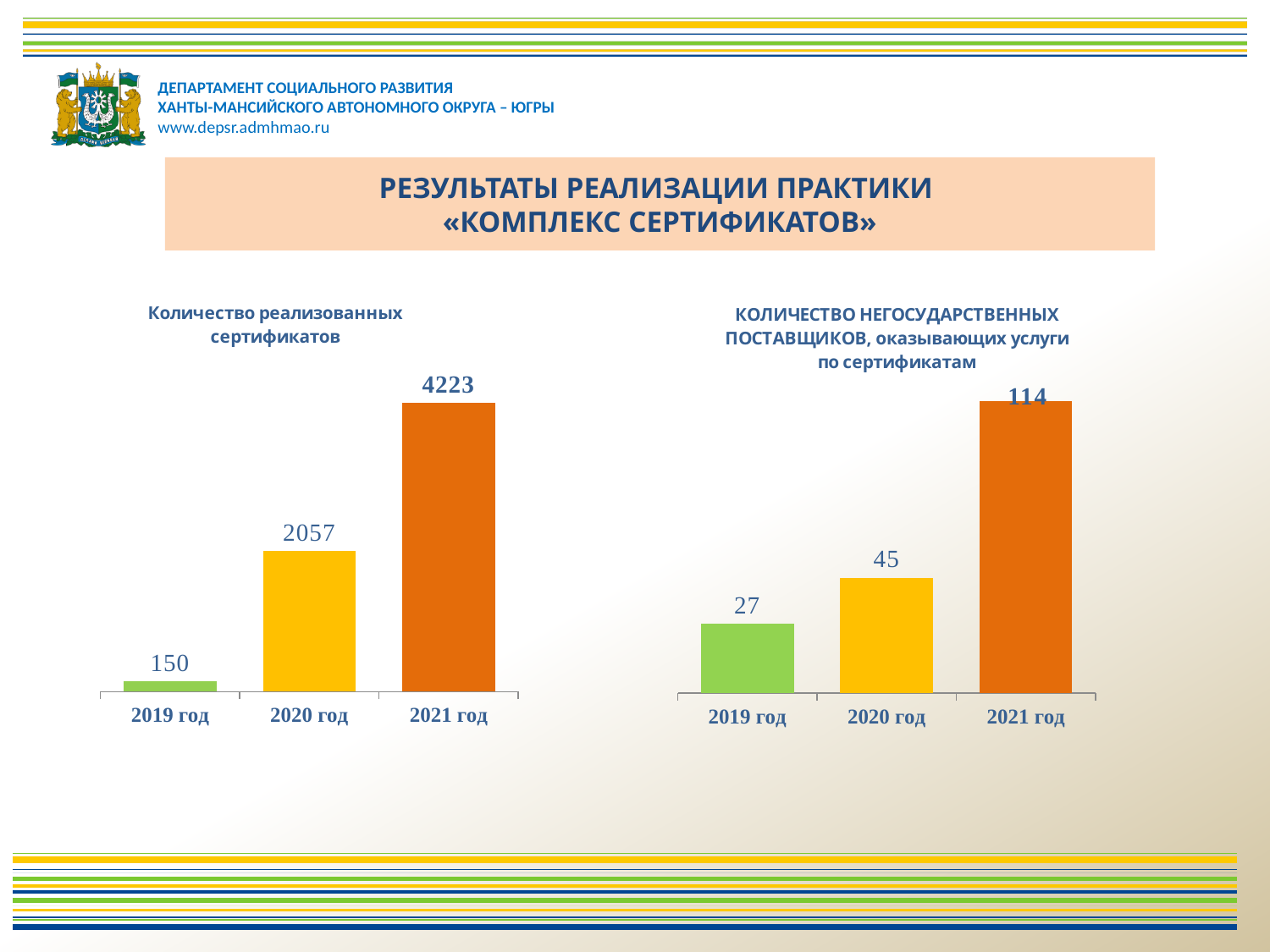
In the right chart 'КОЛИЧЕСТВО НЕГОСУДАРСТВЕННЫХ ПОСТАВЩИКОВ', which is larger: the value for 2019 год or 2020 год? 2020 год In the right chart 'КОЛИЧЕСТВО НЕГОСУДАРСТВЕННЫХ ПОСТАВЩИКОВ', what is the difference between the values for 2021 год and 2019 год? 87 In the right chart 'КОЛИЧЕСТВО НЕГОСУДАРСТВЕННЫХ ПОСТАВЩИКОВ', which year has the highest value? 2021 год What colour is the bar for 2021 год in the right chart 'КОЛИЧЕСТВО НЕГОСУДАРСТВЕННЫХ ПОСТАВЩИКОВ'? Orange What kind of chart is the right chart 'КОЛИЧЕСТВО НЕГОСУДАРСТВЕННЫХ ПОСТАВЩИКОВ'? Bar chart In the left chart 'Количество реализованных сертификатов', what is the difference between the values for 2021 год and 2020 год? 2166 How many categories does the left chart 'Количество реализованных сертификатов' show? 3 In the left chart 'Количество реализованных сертификатов', do the values rise or fall from 2019 год to 2021 год? Rise In the right chart 'КОЛИЧЕСТВО НЕГОСУДАРСТВЕННЫХ ПОСТАВЩИКОВ', what is the value for 2020 год? 45 In the left chart 'Количество реализованных сертификатов', what is the value for 2019 год? 150 In the left chart 'Количество реализованных сертификатов', what is the value for 2021 год? 4223 In the left chart 'Количество реализованных сертификатов', which year has the lowest value? 2019 год